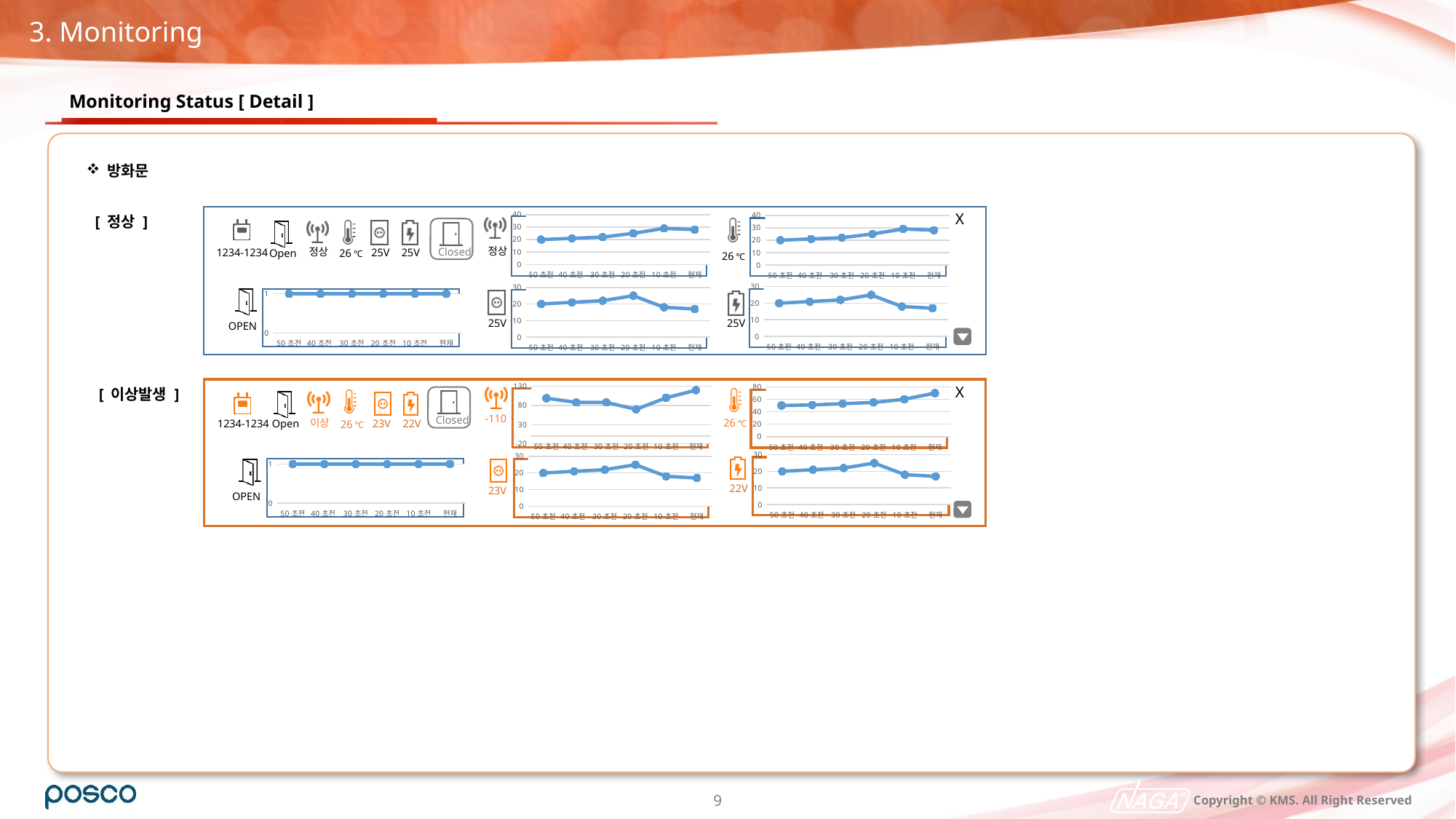
In the 이상발생 panel's top-left chart (next to -110), which x-axis category has the lowest value? 20 초전 What is the label of the last x-axis category in the 정상 panel's top-left chart (next to the 정상 signal icon)? 현재 In the 정상 panel's top-left chart (next to the 정상 signal icon), is the value at 현재 greater or less than 20? greater In the 이상발생 panel's top-right temperature chart (next to 26 ℃), which x-axis category has the highest value? 현재 In the 정상 panel's bottom-middle chart (next to the 25V plug icon), which x-axis category has the highest value? 20 초전 In the 정상 panel's bottom-middle chart (next to the 25V plug icon), is the value at 현재 greater or less than 20? less In the 정상 panel's top-right temperature chart (next to 26 ℃), do the values generally rise or fall from 50 초전 to 현재? rise How many data points are plotted in the 정상 panel's top-right temperature chart (next to 26 ℃)? 6 What value does the 정상 panel's bottom-left OPEN chart show at 현재? 1 In the 이상발생 panel's top-right temperature chart (next to 26 ℃), is the value at 50 초전 greater or less than 40? greater In the 이상발생 panel's top-left chart (next to -110), which is larger: the value at 50 초전 or the value at 현재? 현재 What type of chart is used in the 정상 panel's top-left chart (next to the 정상 signal icon)? line chart